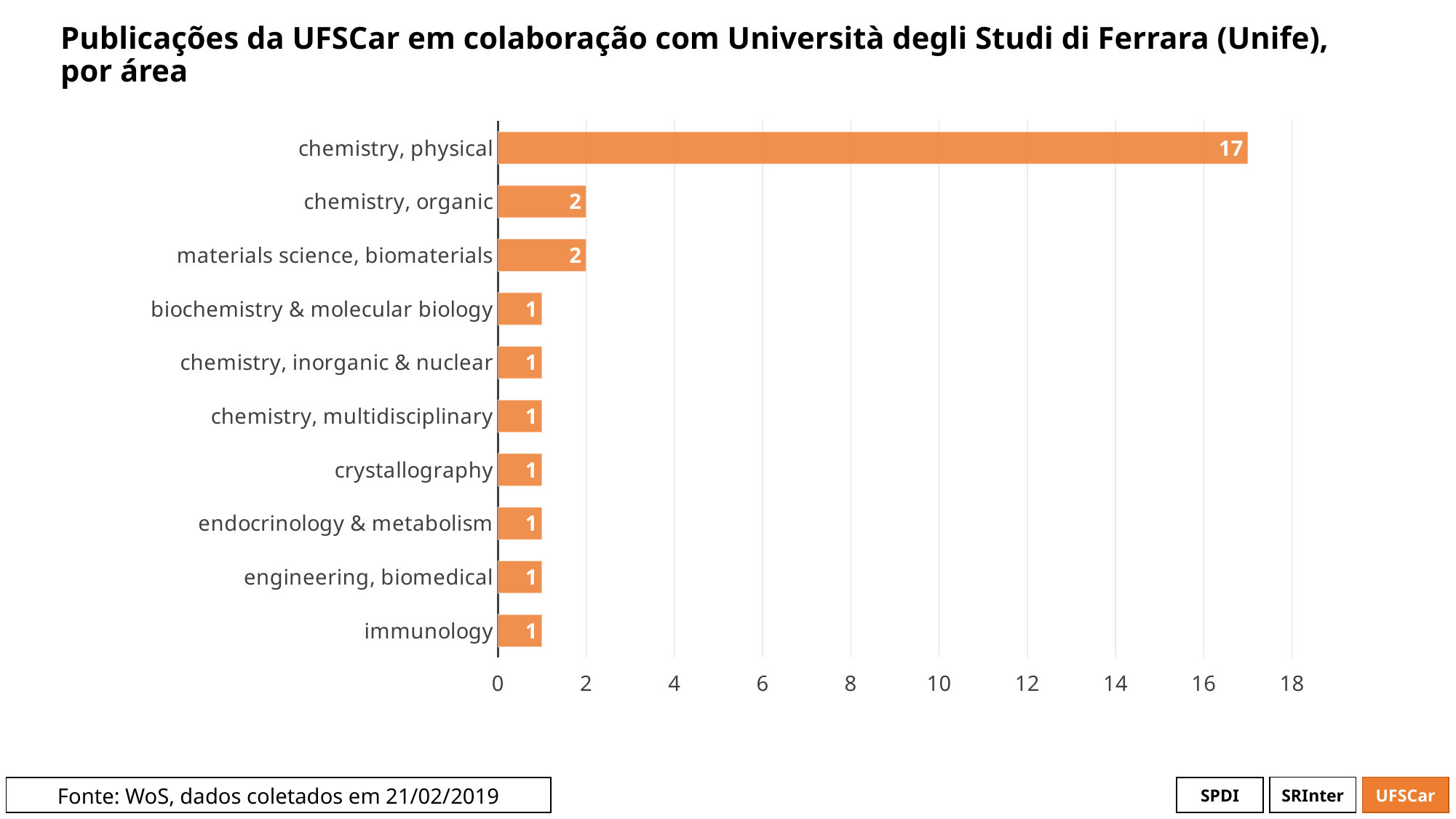
Which category has the highest value? chemistry, physical What is the value for materials science, biomaterials? 2 What is the highest tick value shown on the x axis? 18 Is the value for chemistry, physical greater or less than 10? greater What is the value for immunology? 1 What is the value for chemistry, physical? 17 What is the difference between the values for chemistry, physical and chemistry, organic? 15 What kind of chart is this? bar chart How many categories have a value of 1? 7 How many categories are shown in the chart? 10 What is the title of the chart? Publicações da UFSCar em colaboração com Università degli Studi di Ferrara (Unife), por área Which is larger, the value for chemistry, organic or the value for crystallography? chemistry, organic